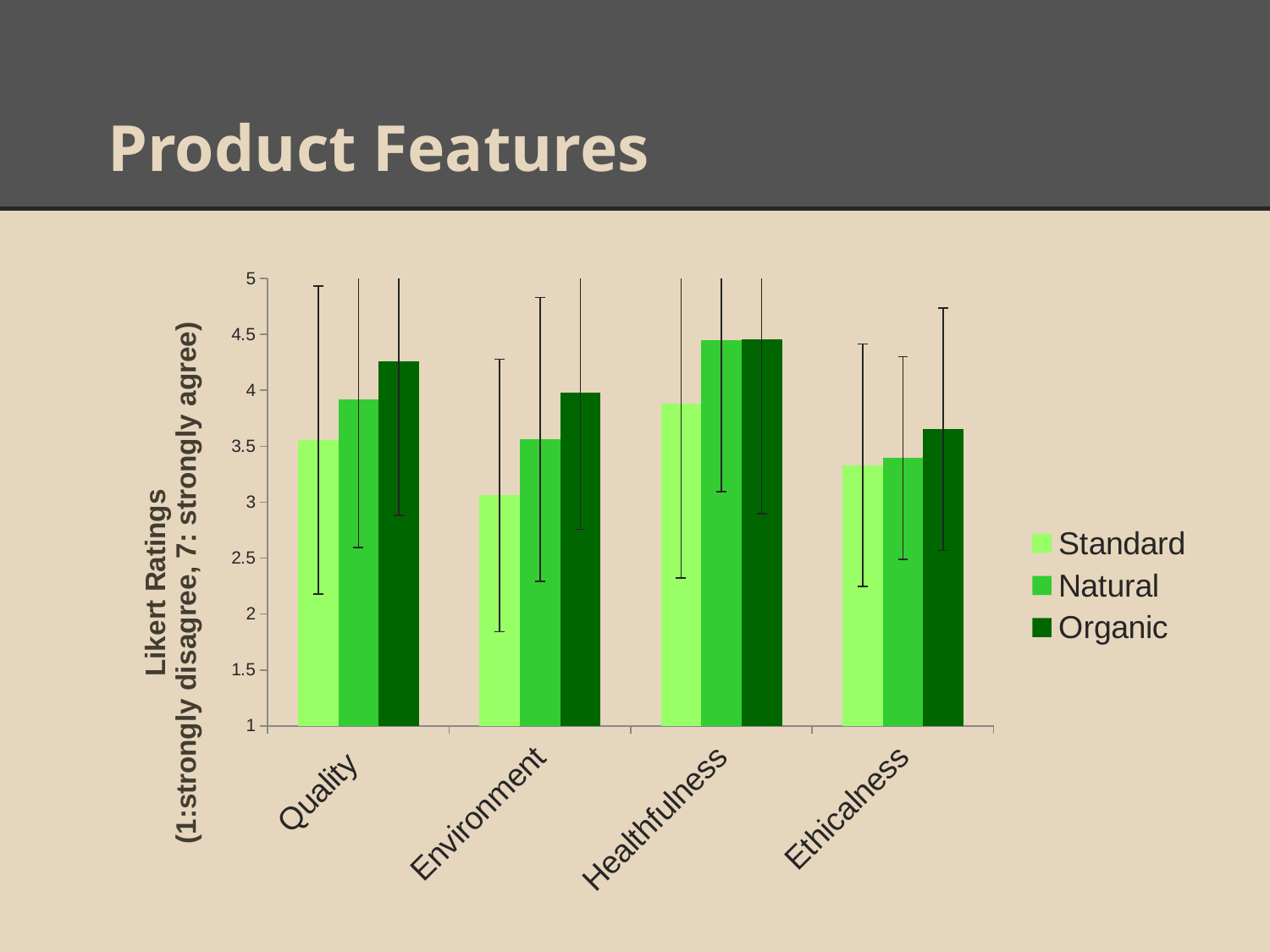
Is the Organic value for Quality greater or less than 4? greater Which category has the lowest Organic value? Ethicalness How many series does the legend list? 3 Which category has the highest Standard value? Healthfulness Is the Standard value for Healthfulness greater or less than 3.5? greater Is the Natural value for Healthfulness greater or less than 4? greater For Environment, which is larger: the Standard value or the Organic value? Organic How many product feature categories are shown on the x axis? 4 What kind of chart is shown on the slide? bar chart What is the label on the y axis? Likert Ratings (1:strongly disagree, 7: strongly agree)